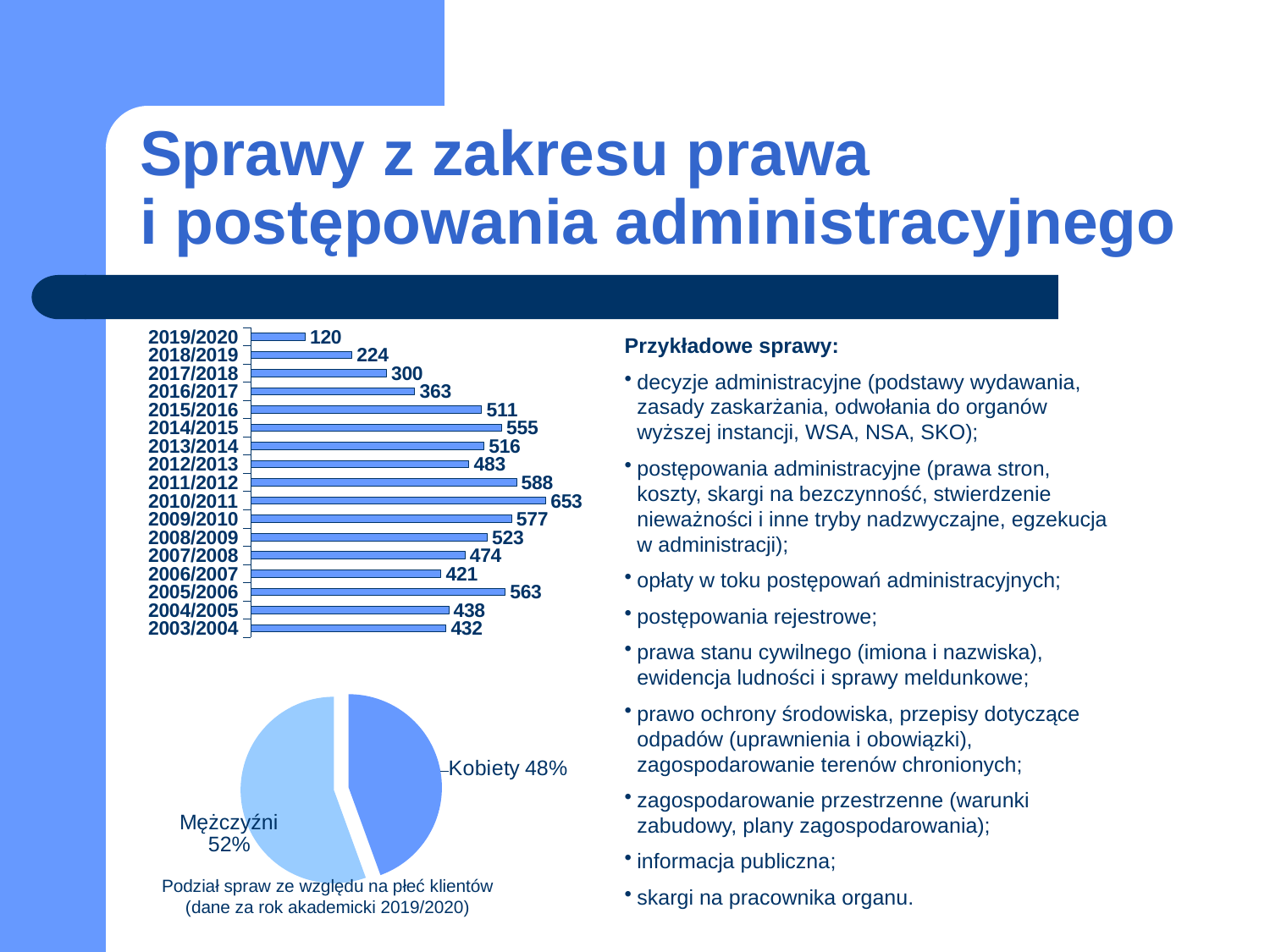
In the bar chart at the top left, what is the value for 2003/2004? 432 In the bar chart at the top left, which academic year has the highest value? 2010/2011 In the bar chart at the top left, which is larger, the value for 2014/2015 or the value for 2013/2014? 2014/2015 In the bar chart at the top left, what is the value for 2010/2011? 653 What kind of chart is the chart at the top left of the slide? Bar chart In the bar chart at the top left, what is the value for 2019/2020? 120 In the pie chart at the bottom left, what share is labelled Kobiety? 48% In the bar chart at the top left, which academic year has the lowest value? 2019/2020 In the pie chart at the bottom left, which slice is larger, Kobiety or Mężczyźni? Mężczyźni In the bar chart at the top left, what is the difference between the values for 2018/2019 and 2019/2020? 104 In the bar chart at the top left, do the values rise or fall from 2016/2017 to 2019/2020? Fall How many academic years are shown in the bar chart at the top left? 17